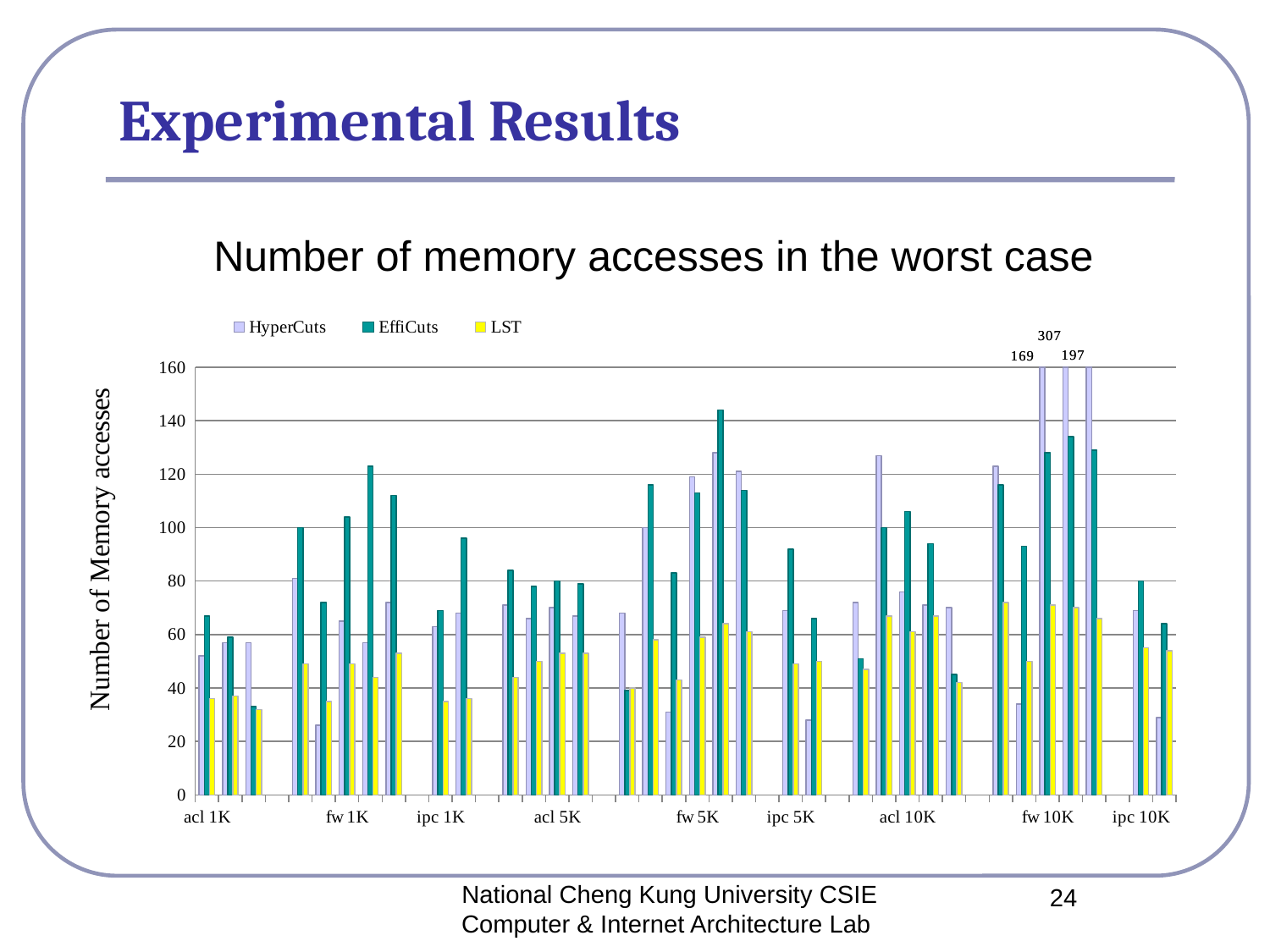
Which x-axis category contains the bars labeled 169, 307 and 197? fw 10K Is the tallest EffiCuts bar in the fw 5K group greater or less than 140? greater Are the LST bars in the acl 1K group greater or less than 40? less What is the largest value printed as a data label on the chart? 307 What is the difference between the bars labeled 197 and 169? 28 What is the title of the chart? Number of memory accesses in the worst case Which series does the bar labeled 307 belong to? HyperCuts What are the three series named in the chart legend? HyperCuts, EffiCuts, LST How many rule-set category labels are shown along the x axis? 9 What is the difference between the bars labeled 307 and 197? 110 What kind of chart is shown on the slide? bar chart How many series does the chart legend list? 3